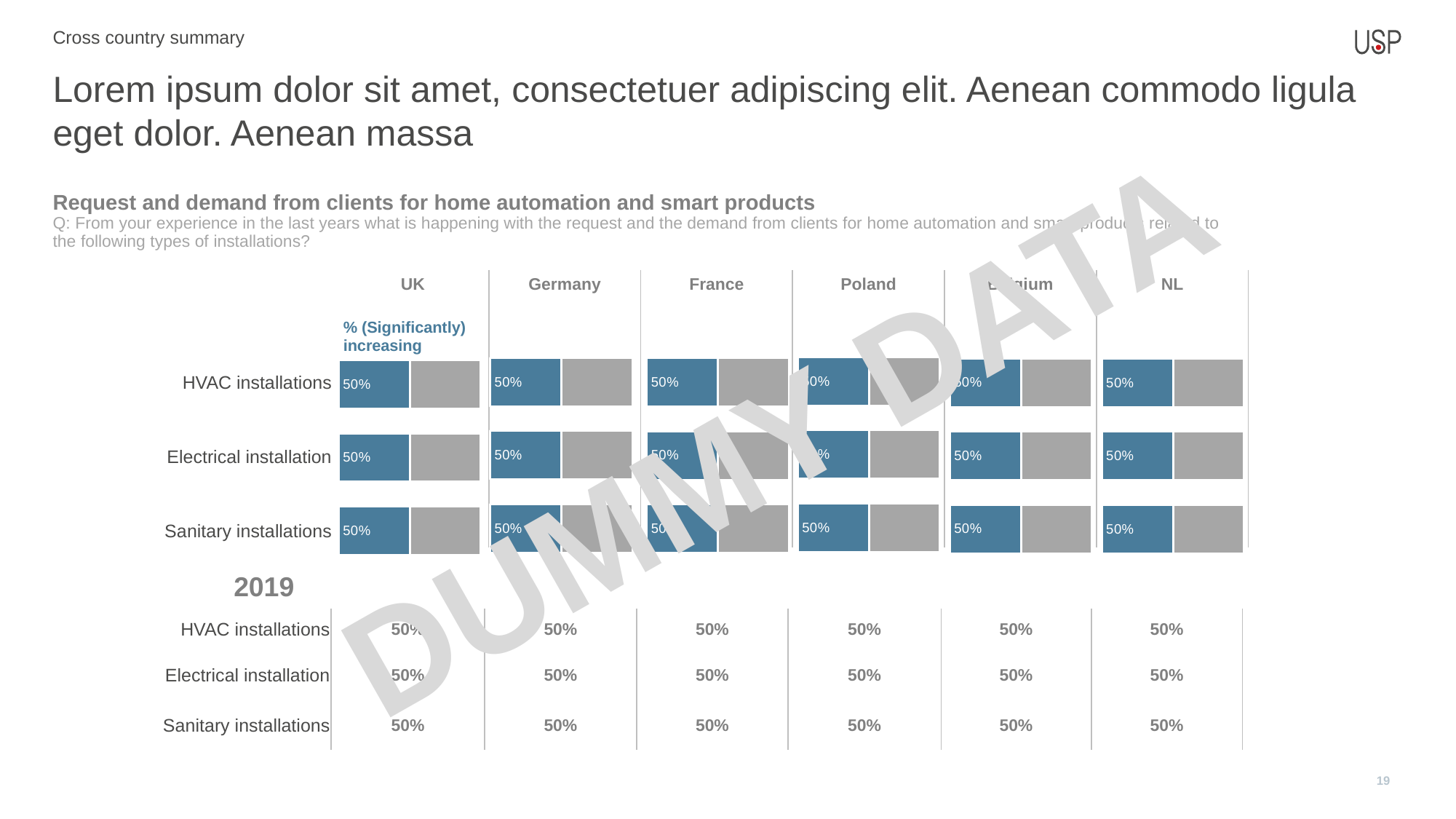
What is the title of the chart section on the slide? Request and demand from clients for home automation and smart products How many country charts are shown in the bar chart row on the slide? 6 In the NL chart, what is the value shown for Sanitary installations? 50% What kind of chart is used for each country on this slide? Bar chart What does the blue segment of the bars represent, according to the label above the UK chart? % (Significantly) increasing How many installation types (categories) are plotted in the UK chart? 3 In the Germany chart, what is the value shown for Electrical installation? 50% In the 2019 table, what is the value for Sanitary installations in NL? 50% In the UK chart, what is the value shown for HVAC installations? 50% In the 2019 table, what is the value for Electrical installation in Germany? 50% In the Poland chart, what is the value shown for Sanitary installations? 50% In the France chart, what is the value shown for HVAC installations? 50%